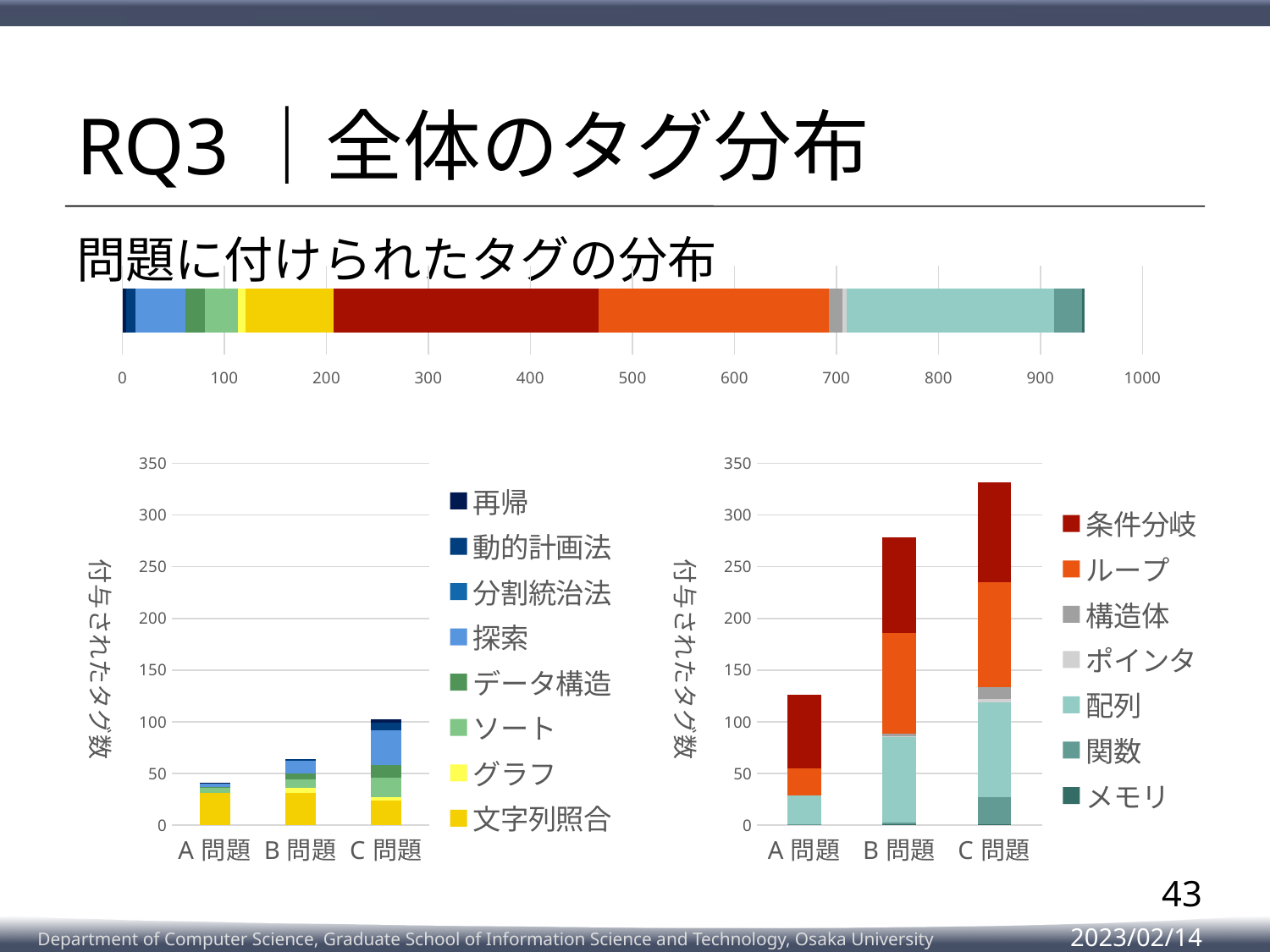
In the bottom-right chart, which category has the shortest stacked bar? A 問題 How many categories are shown on the x axis of the bottom-right chart? 3 How many series does the legend of the bottom-right chart list? 7 In the bottom-right chart, is the total for A 問題 greater or less than 150? less In the bottom-right chart, is the total for B 問題 greater or less than 250? greater In the bottom-left chart, is the total for B 問題 greater or less than 100? less In the bottom-left chart, which category has the shortest stacked bar? A 問題 In the bottom-left chart, which category has the tallest stacked bar? C 問題 How many series does the legend of the bottom-left chart list? 8 Do the stacked bar totals in the bottom-right chart rise or fall from A 問題 to C 問題? rise In the bottom-right chart, which category has the tallest stacked bar? C 問題